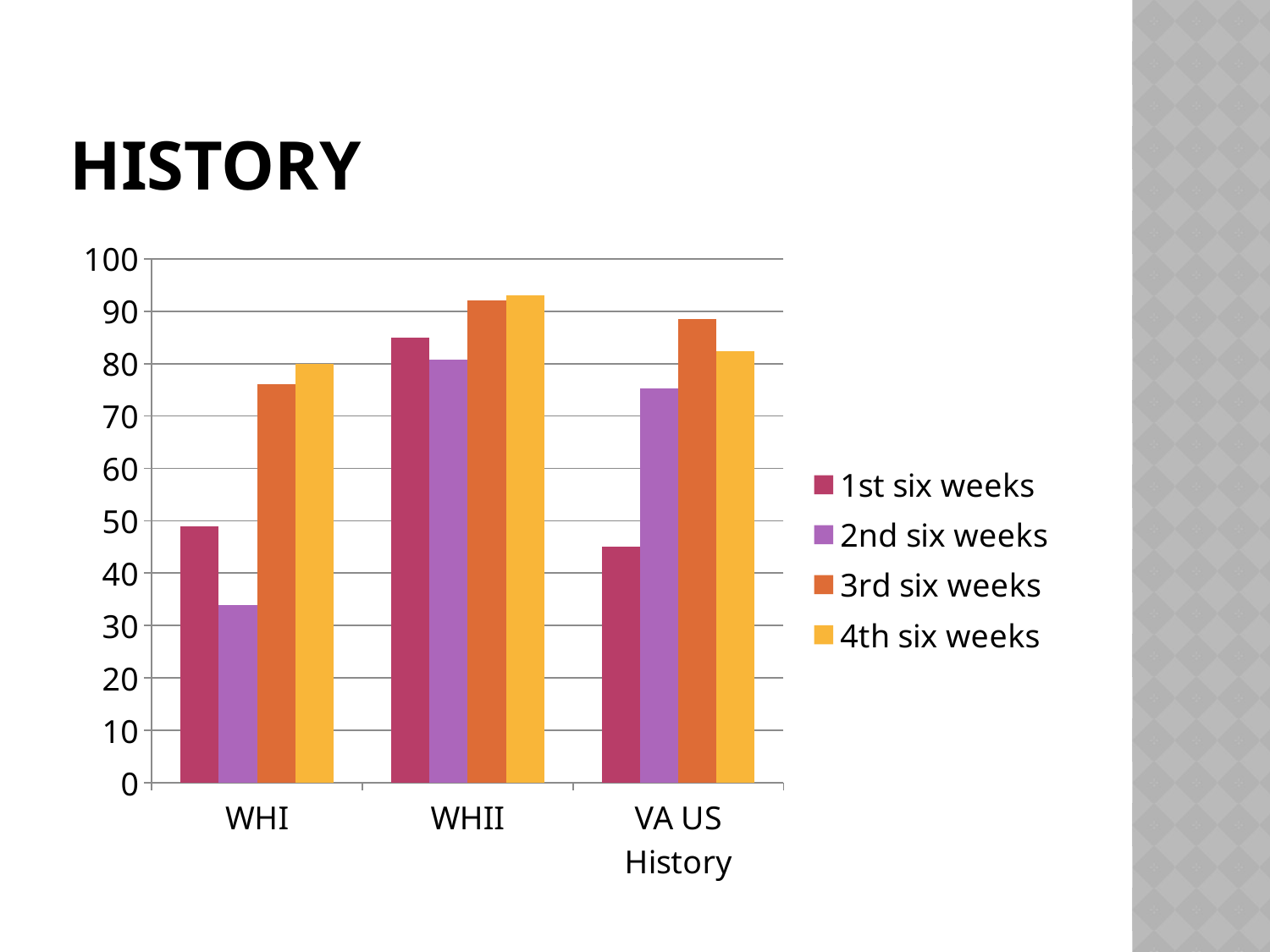
How many categories are shown on the x axis of the chart? 3 Which legend entry is shown in yellow? 4th six weeks Is the value for 1st six weeks in VA US History greater or less than 50? less What kind of chart is shown on the slide? bar chart Is the value for 1st six weeks in WHII greater or less than 80? greater Which is larger: the 3rd six weeks value for WHI or for WHII? WHII Is the value for 3rd six weeks in VA US History greater or less than 80? greater Which series has the lowest bar in the whole chart? 2nd six weeks (WHI) How many series does the chart's legend list? 4 Which series has the highest value for VA US History? 3rd six weeks